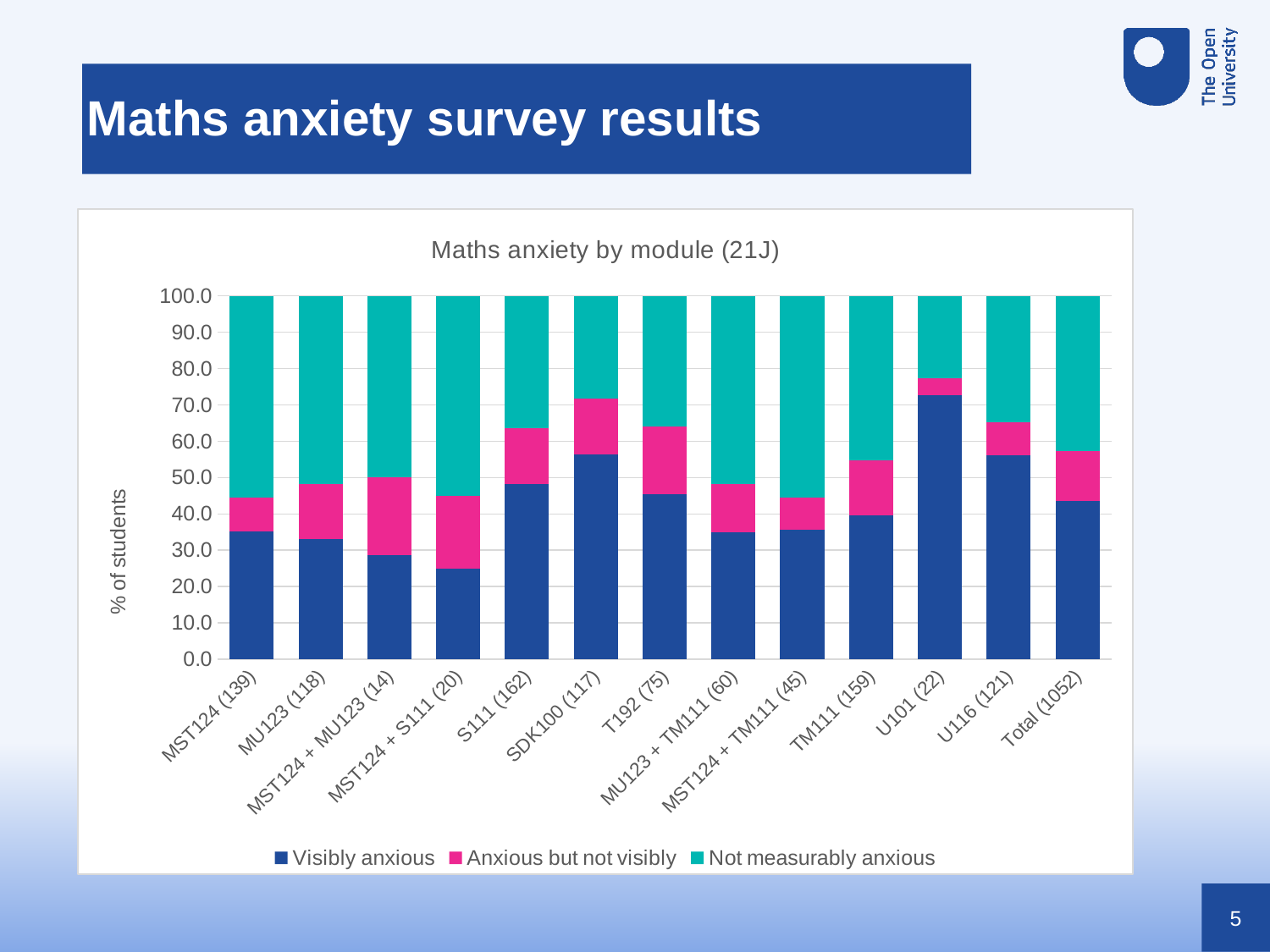
Which module has the lowest percentage of visibly anxious students? MST124 + S111 (20) Which module has the smallest share of students who are not measurably anxious? U101 (22) Is the visibly anxious value for Total (1052) greater or less than 40.0? greater How many series does the legend list? 3 Which module has the highest percentage of visibly anxious students? U101 (22) What is the title of the chart? Maths anxiety by module (21J) Is the visibly anxious value for U101 (22) greater or less than 70.0? greater What is the label on the y axis? % of students Is the visibly anxious value for MST124 + S111 (20) greater or less than 30.0? less Which has a larger visibly anxious percentage, SDK100 (117) or T192 (75)? SDK100 (117) What kind of chart is shown on the slide? Stacked bar chart How many module categories are shown on the x axis? 13